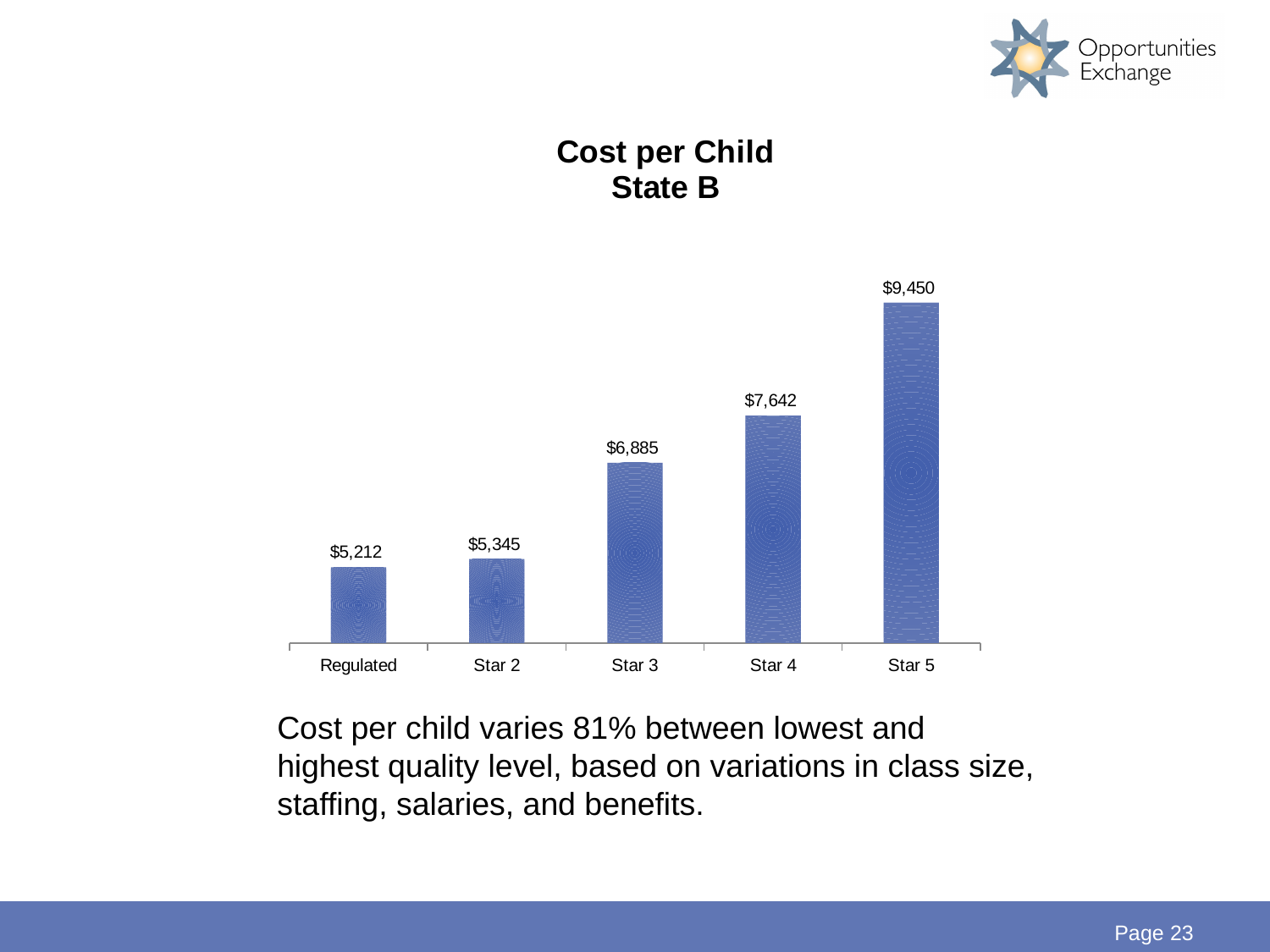
What is the cost per child for Star 5? $9,450 Do the values rise or fall from Regulated to Star 5? Rise Which category has the lowest cost per child? Regulated What is the cost per child for Regulated? $5,212 What is the cost per child for Star 2? $5,345 What is the difference in cost per child between Star 5 and Star 4? $1,808 How many categories are shown on the chart? 5 What kind of chart is shown on the slide? Bar chart Which has a higher cost per child, Star 4 or Star 3? Star 4 Which category has the highest cost per child? Star 5 What is the cost per child for Star 3? $6,885 What is the difference in cost per child between Star 3 and Star 2? $1,540